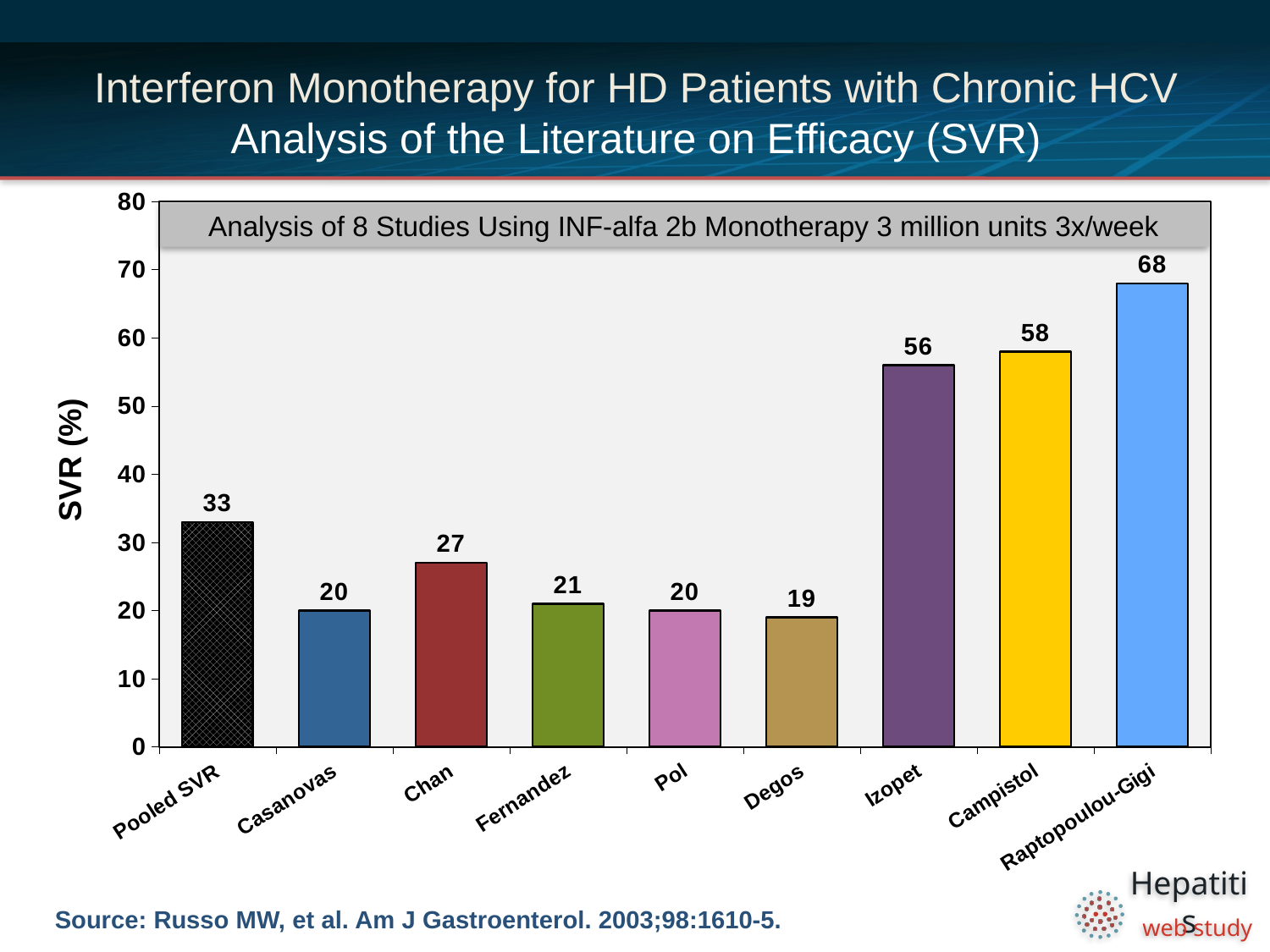
What is the SVR (%) value for Izopet? 56 What kind of chart is shown on the slide? bar chart Which category has the highest SVR (%)? Raptopoulou-Gigi What is the SVR (%) value for Pooled SVR? 33 Which category has the lowest SVR (%)? Degos Is the SVR (%) value for Campistol greater or less than 50? greater What is the label of the y axis of the chart? SVR (%) What is the difference in SVR (%) between Raptopoulou-Gigi and Campistol? 10 How many categories are shown on the x axis of the chart? 9 Which has a higher SVR (%), Fernandez or Izopet? Izopet What is the difference in SVR (%) between Pooled SVR and Casanovas? 13 What is the SVR (%) value for Chan? 27